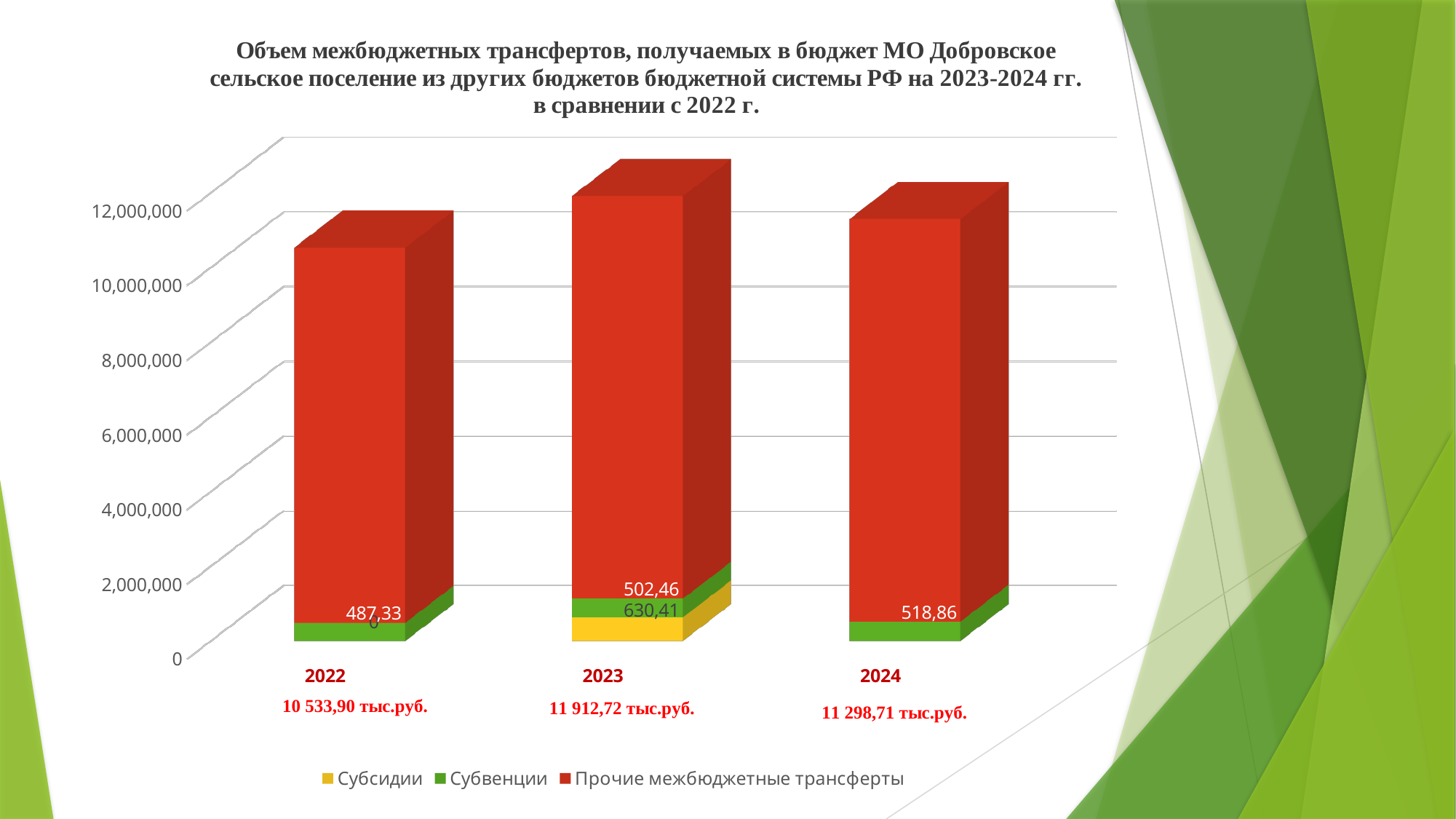
In 2023, which is larger: Субсидии or Субвенции? Субсидии What total amount is printed under the 2023 bar? 11 912,72 тыс.руб. How many years (categories) are shown on the x axis? 3 What is the value of Субвенции for 2023? 502,46 Which year has the highest total bar? 2023 What kind of chart is shown on the slide? Stacked bar chart What is the value of Субвенции for 2022? 487,33 Which year has the lowest total bar? 2022 What is the value of Субвенции for 2024? 518,86 What is the value of Субсидии for 2023? 630,41 How many series does the legend list? 3 By how much does the Субвенции value for 2024 exceed the Субвенции value for 2022? 31,53